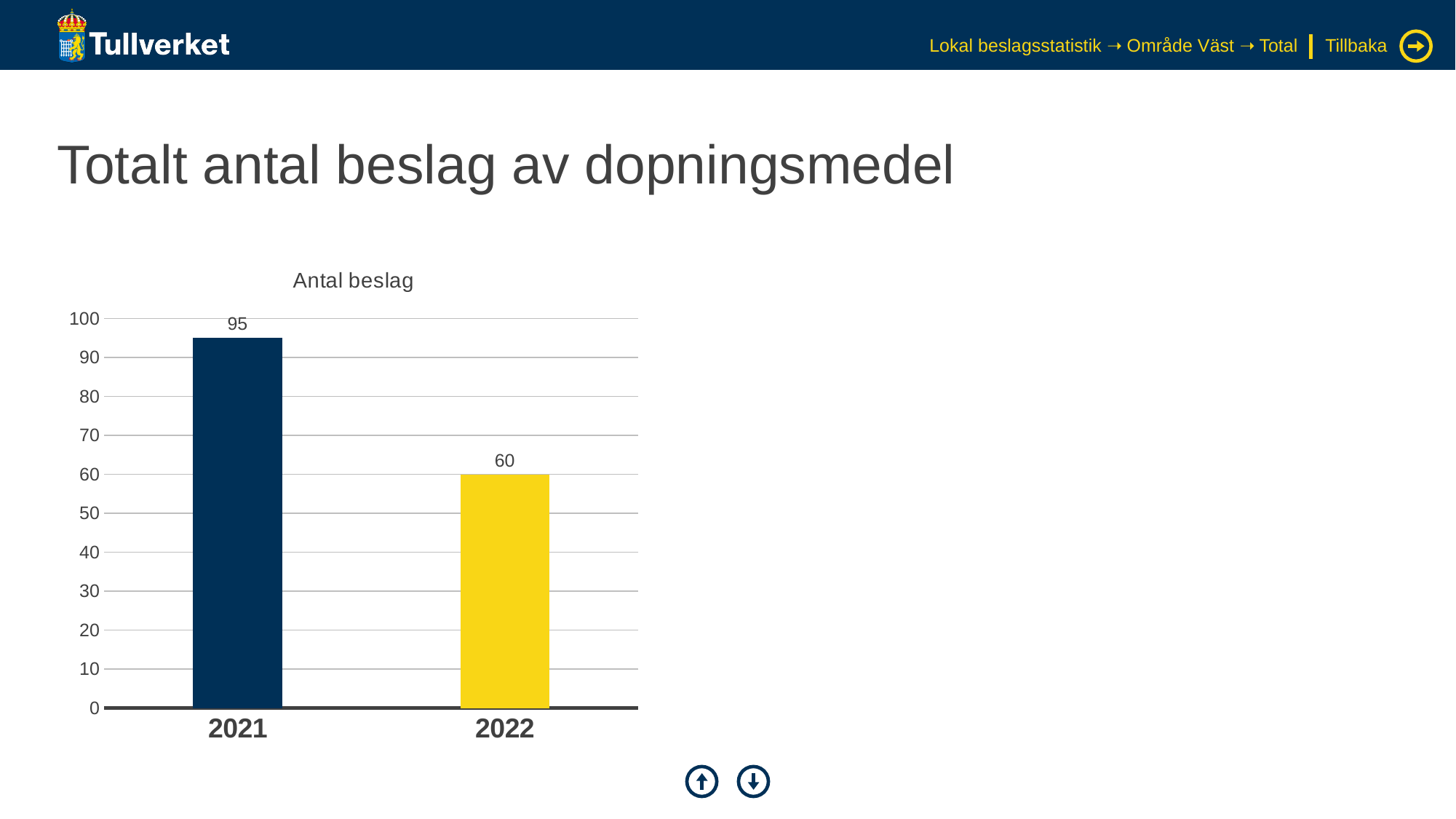
Is the value for 2022 greater or less than 70? less What is the title of the chart? Antal beslag Which year has the highest number of seizures in the chart? 2021 Do the values rise or fall from 2021 to 2022? fall What is the value for 2022 in the Antal beslag chart? 60 Which year has the lowest number of seizures in the chart? 2022 What is the value for 2021 in the Antal beslag chart? 95 How many years are shown on the x axis of the chart? 2 Is the value for 2021 greater or less than 90? greater What kind of chart is shown on the slide? bar chart Which is larger, the value for 2021 or the value for 2022? 2021 What is the difference between the values for 2021 and 2022? 35